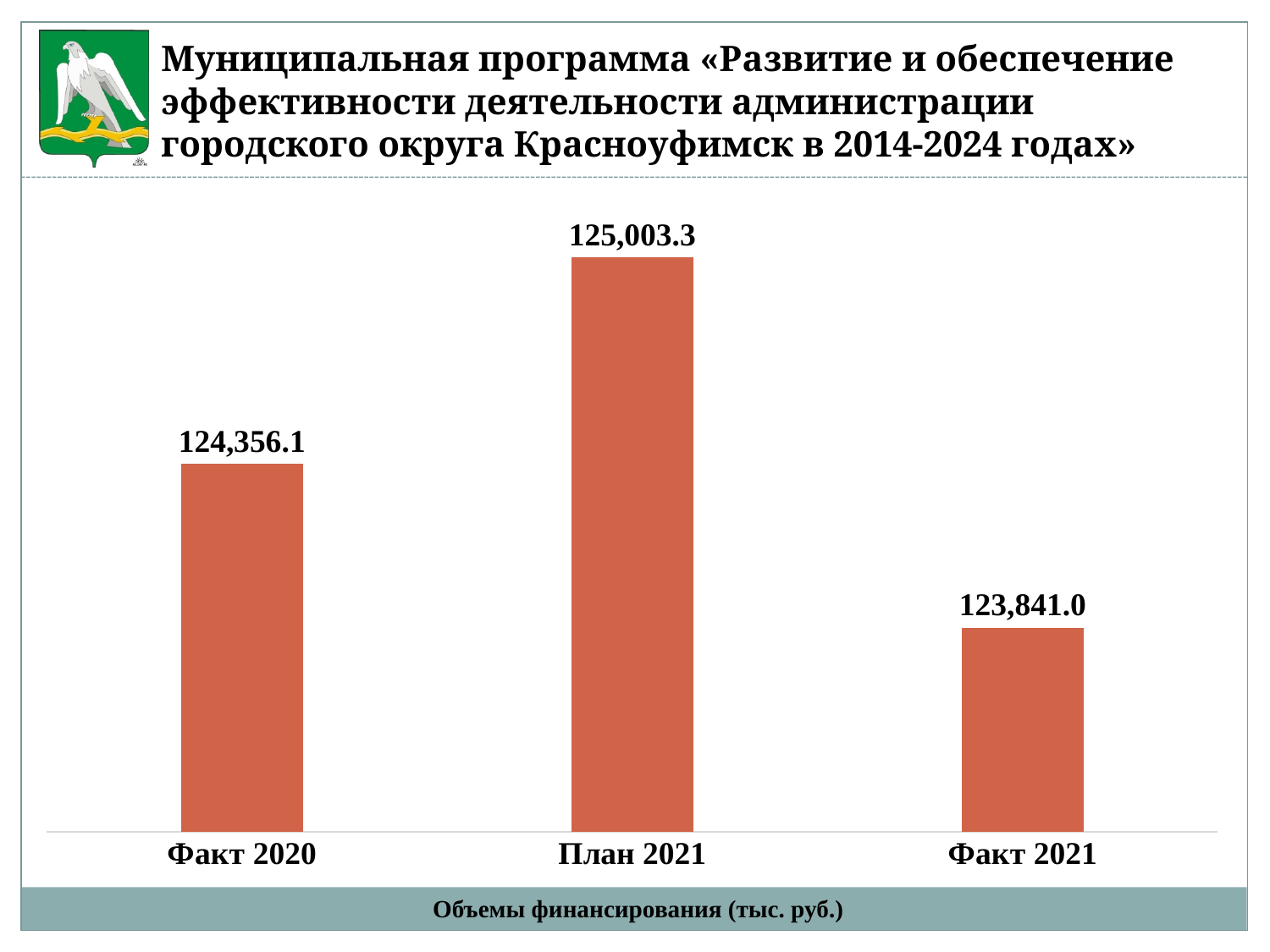
Does the value rise or fall from План 2021 to Факт 2021? Falls What is the value for Факт 2021? 123,841.0 Which is larger, Факт 2020 or План 2021? План 2021 How many categories are shown in the chart? 3 Which category has the lowest value? Факт 2021 Which category has the highest value? План 2021 What is the value for Факт 2020? 124,356.1 What kind of chart is shown on the slide? Bar chart What is the difference between План 2021 and Факт 2021? 1,162.3 What is the title shown beneath the chart? Объемы финансирования (тыс. руб.) What is the value for План 2021? 125,003.3 What is the difference between Факт 2020 and Факт 2021? 515.1